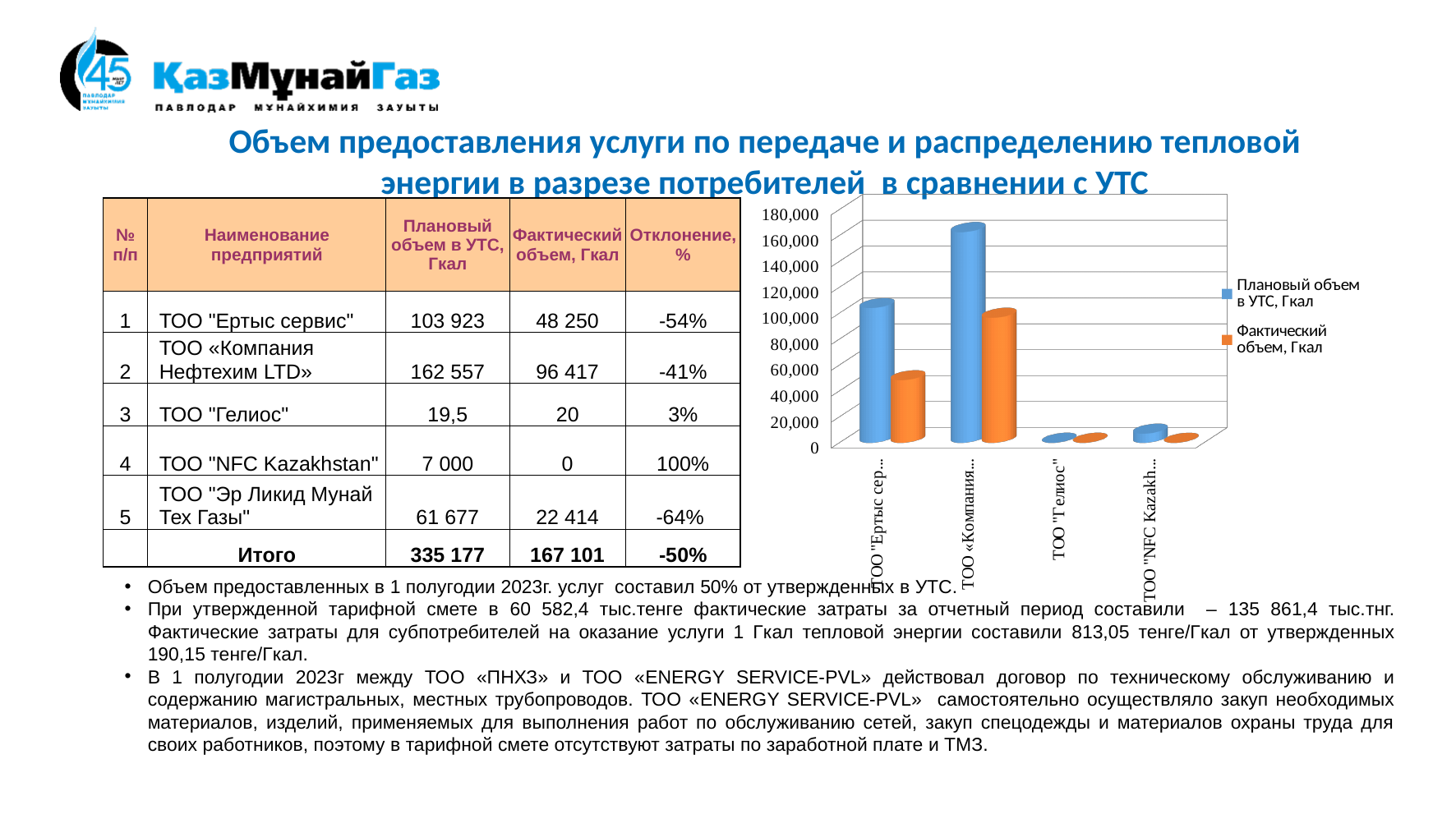
Is the actual volume (Фактический объем) for ТОО "Ертыс сервис" greater or less than 60,000? less How many categories (enterprises) are plotted on the chart's x axis? 4 Which enterprise has the highest actual volume (Фактический объем, Гкал) on the chart? ТОО «Компания Нефтехим LTD» What is the planned volume in УТС (Гкал) for ТОО "Ертыс сервис" as printed on the slide? 103 923 For ТОО "Ертыс сервис", which is larger: the planned volume or the actual volume? planned volume Is the planned volume (Плановый объем в УТС) for ТОО «Компания Нефтехим LTD» greater or less than 140,000? greater Which is larger: the planned volume for ТОО «Компания Нефтехим LTD» or the planned volume for ТОО "Ертыс сервис"? ТОО «Компания Нефтехим LTD» What kind of chart is shown on the slide? bar chart How many series does the chart legend list? 2 What colour are the bars for the series "Фактический объем, Гкал"? orange Which enterprise has the highest planned volume (Плановый объем в УТС, Гкал) on the chart? ТОО «Компания Нефтехим LTD» Is the actual volume (Фактический объем) for ТОО «Компания Нефтехим LTD» greater or less than 80,000? greater